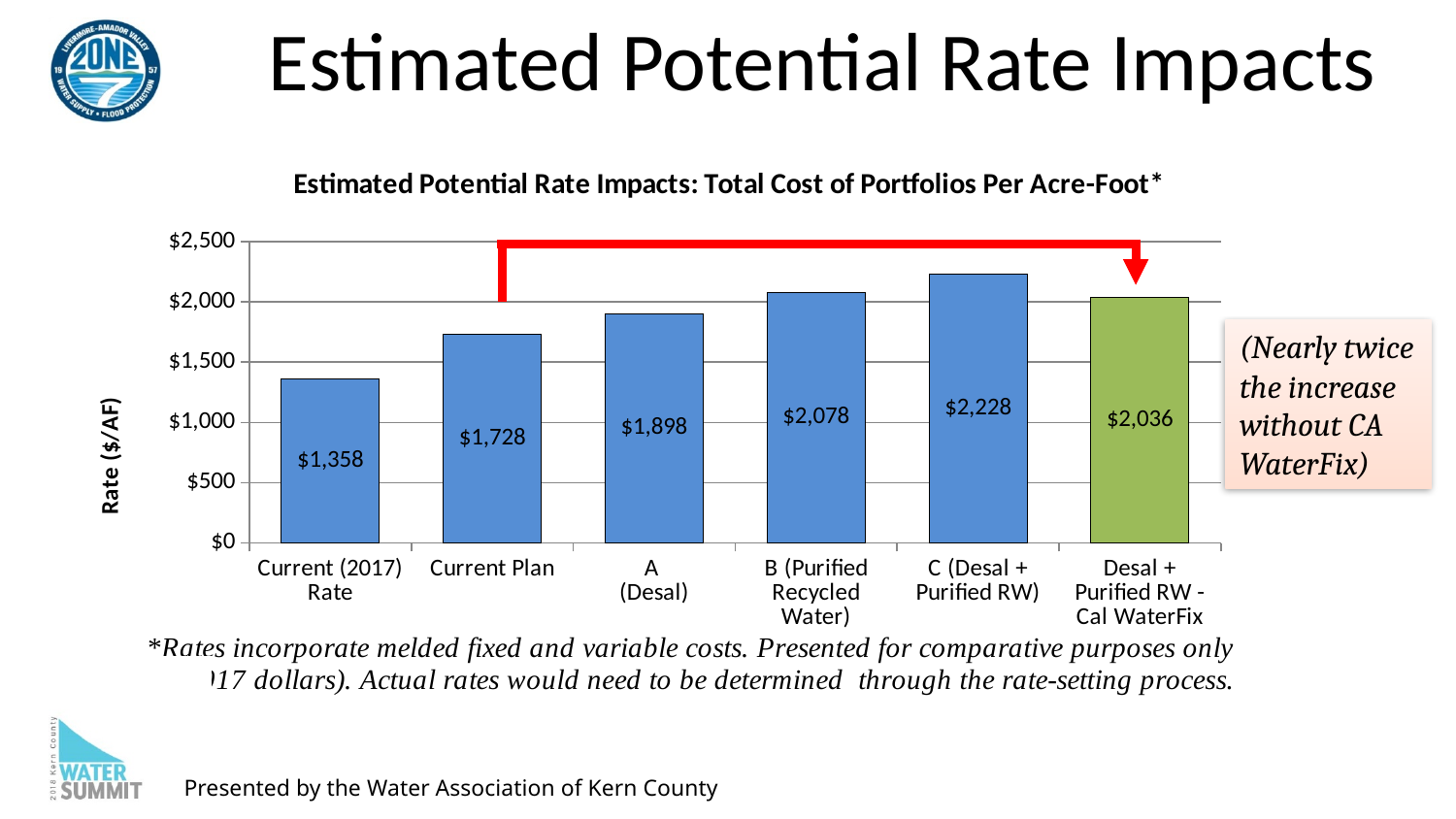
How many categories are shown on the x axis? 6 What kind of chart is this? bar chart What is the value for Desal + Purified RW - Cal WaterFix? $2,036 Is the value for A (Desal) greater or less than $2,000? less What is the y-axis label of the chart? Rate ($/AF) What is the difference between C (Desal + Purified RW) and Current (2017) Rate? $870 What is the value for Current (2017) Rate? $1,358 Which is larger, A (Desal) or Current Plan? A (Desal) Which category has the lowest value? Current (2017) Rate What is the value for B (Purified Recycled Water)? $2,078 Which category has the highest value? C (Desal + Purified RW) What is the value for Current Plan? $1,728